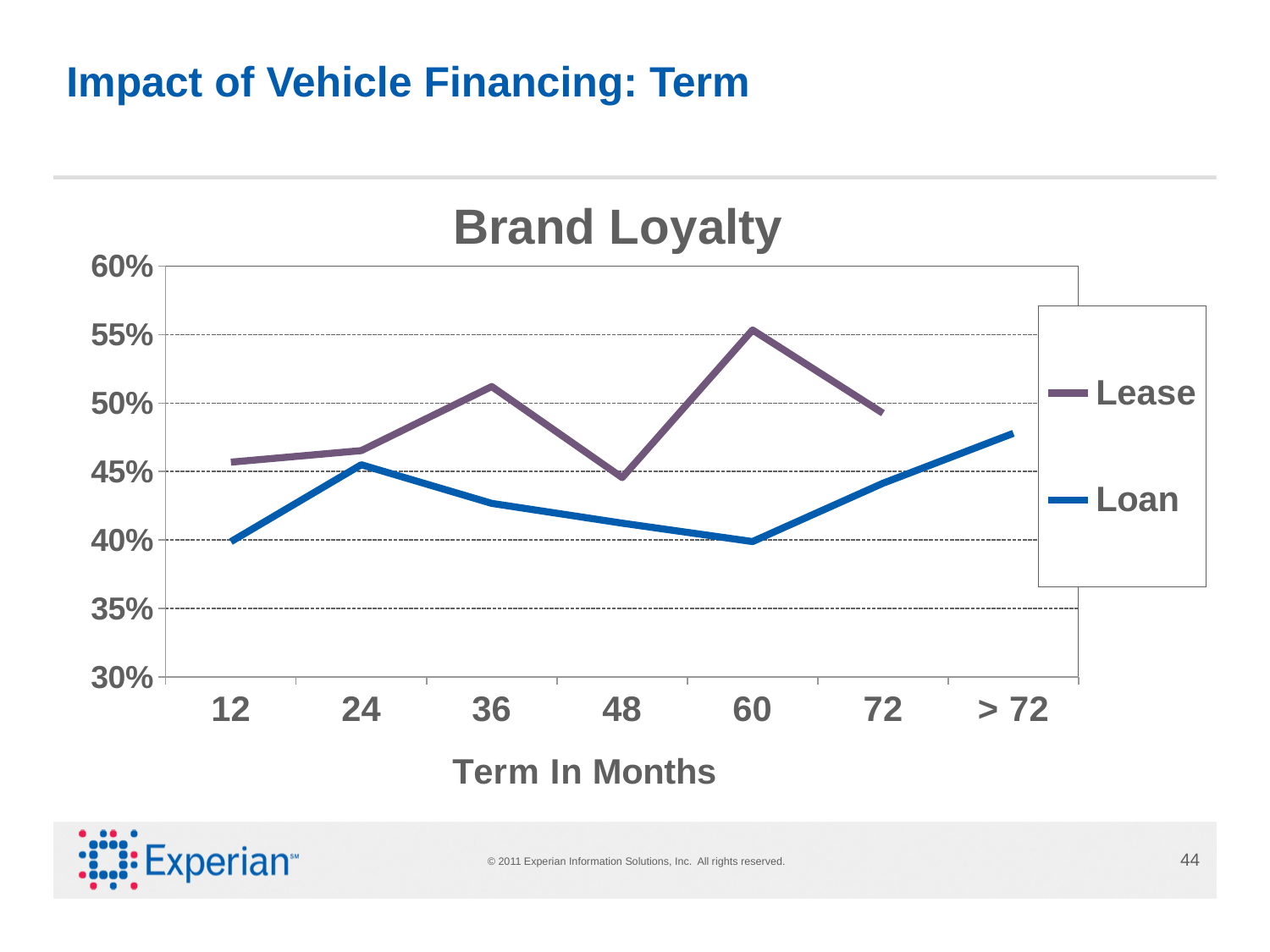
What is the title of the chart? Brand Loyalty Does the Loan series rise or fall between 60 months and > 72 months? rise Is the value for Loan at 36 months greater or less than 45%? less At which term in months does the Lease series reach its lowest value? 48 Is the value for Lease at 60 months greater or less than 50%? greater How many term categories are shown on the x axis? 7 At a term of 36 months, which series has the higher brand loyalty, Lease or Loan? Lease How many series does the legend list? 2 Is the value for Loan at > 72 months greater or less than 45%? greater What kind of chart is shown on the slide? line chart At which term in months does the Lease series reach its highest value? 60 At which term in months does the Loan series reach its highest value? > 72